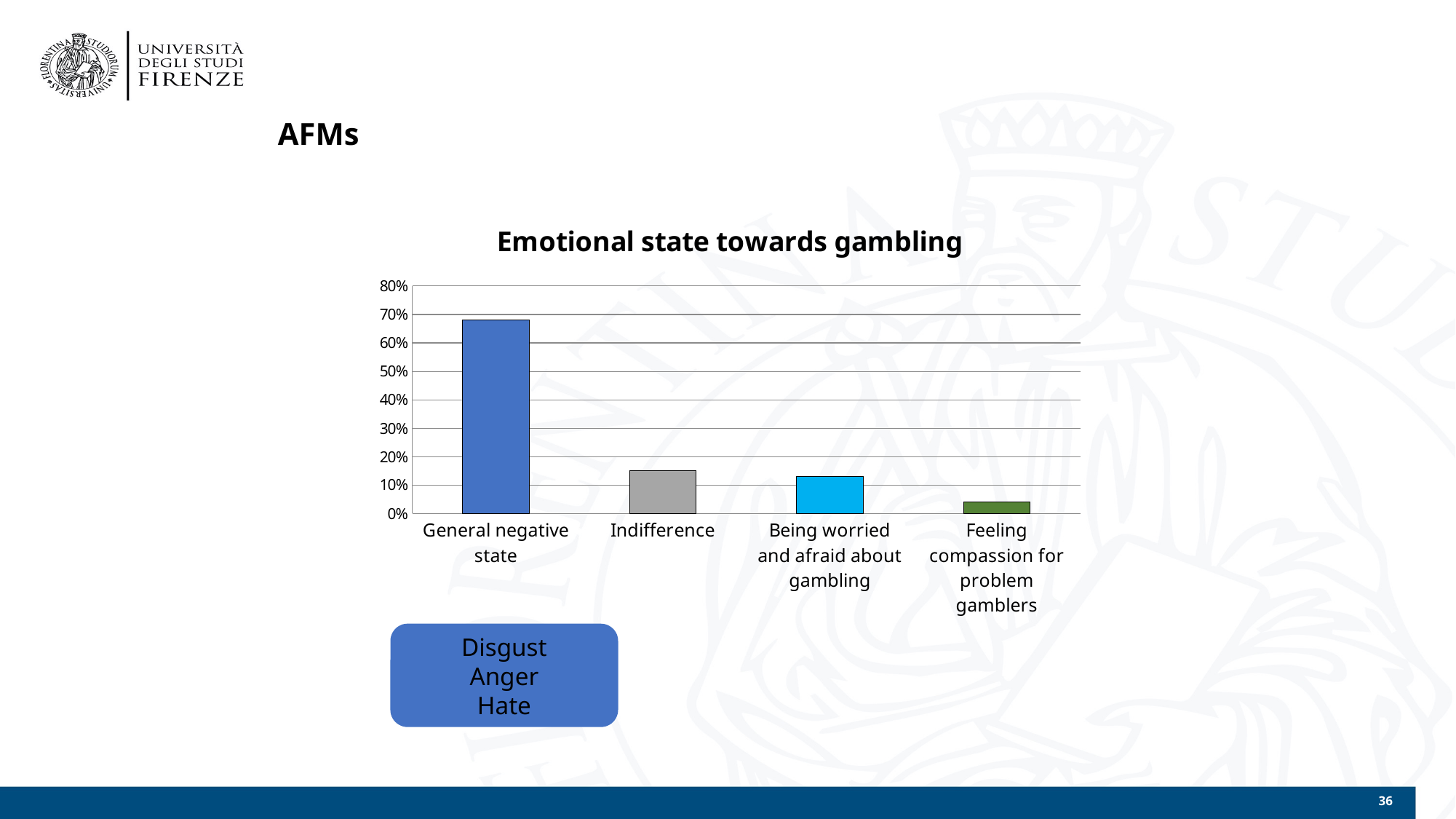
What is the title of the chart? Emotional state towards gambling Which is larger, the value for Being worried and afraid about gambling or the value for Feeling compassion for problem gamblers? Being worried and afraid about gambling Which is larger, the value for General negative state or the value for Indifference? General negative state Is the value for Feeling compassion for problem gamblers greater or less than 10%? less Which category has the highest value in the chart? General negative state Which category has the lowest value in the chart? Feeling compassion for problem gamblers Is the value for Indifference greater or less than 20%? less What colour is the bar for Feeling compassion for problem gamblers? Green What type of chart is shown on the slide? Bar chart How many categories are shown on the x axis of the chart? 4 Is the value for Being worried and afraid about gambling greater or less than 10%? greater